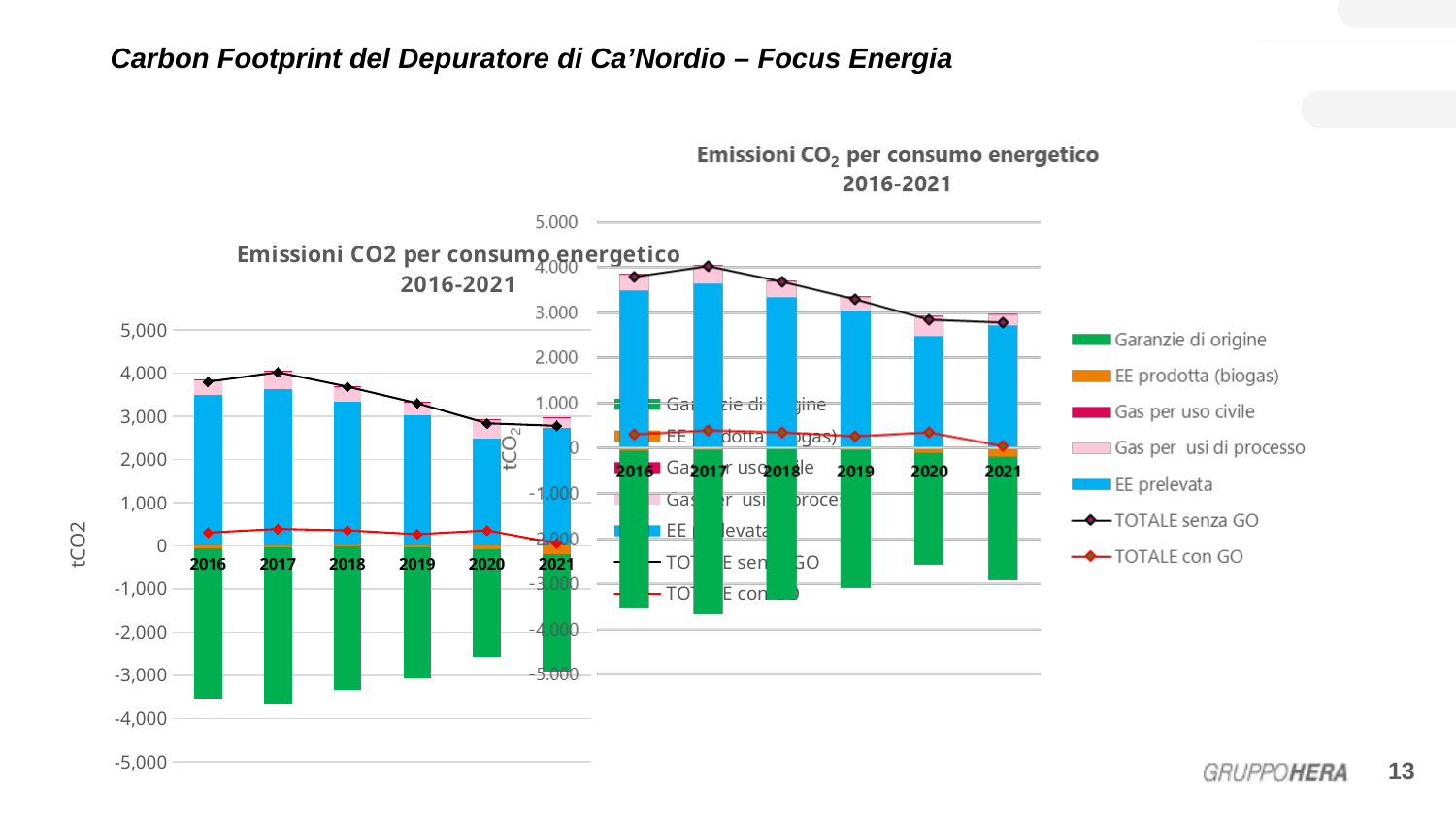
On the left chart, does the TOTALE senza GO line rise or fall from 2017 to 2021? fall On the left chart, is the TOTALE senza GO value for 2016 greater or less than 3,000? greater On the left chart, which year has the larger TOTALE senza GO value, 2016 or 2019? 2016 On the left chart, in which year is the TOTALE senza GO line at its highest? 2017 On the left chart, is the Garanzie di origine value for 2016 greater or less than -3,000? less On the left chart, how many years are shown on the x axis? 6 On the right chart, how many entries does the legend list? 7 On the left chart, is the TOTALE con GO value for 2016 greater or less than 1,000? less On the left chart, what kind of chart is used to show the emission categories (the coloured segments)? bar chart On the right chart, which legend entry is shown in blue? EE prelevata What is the y-axis label of the left chart? tCO2